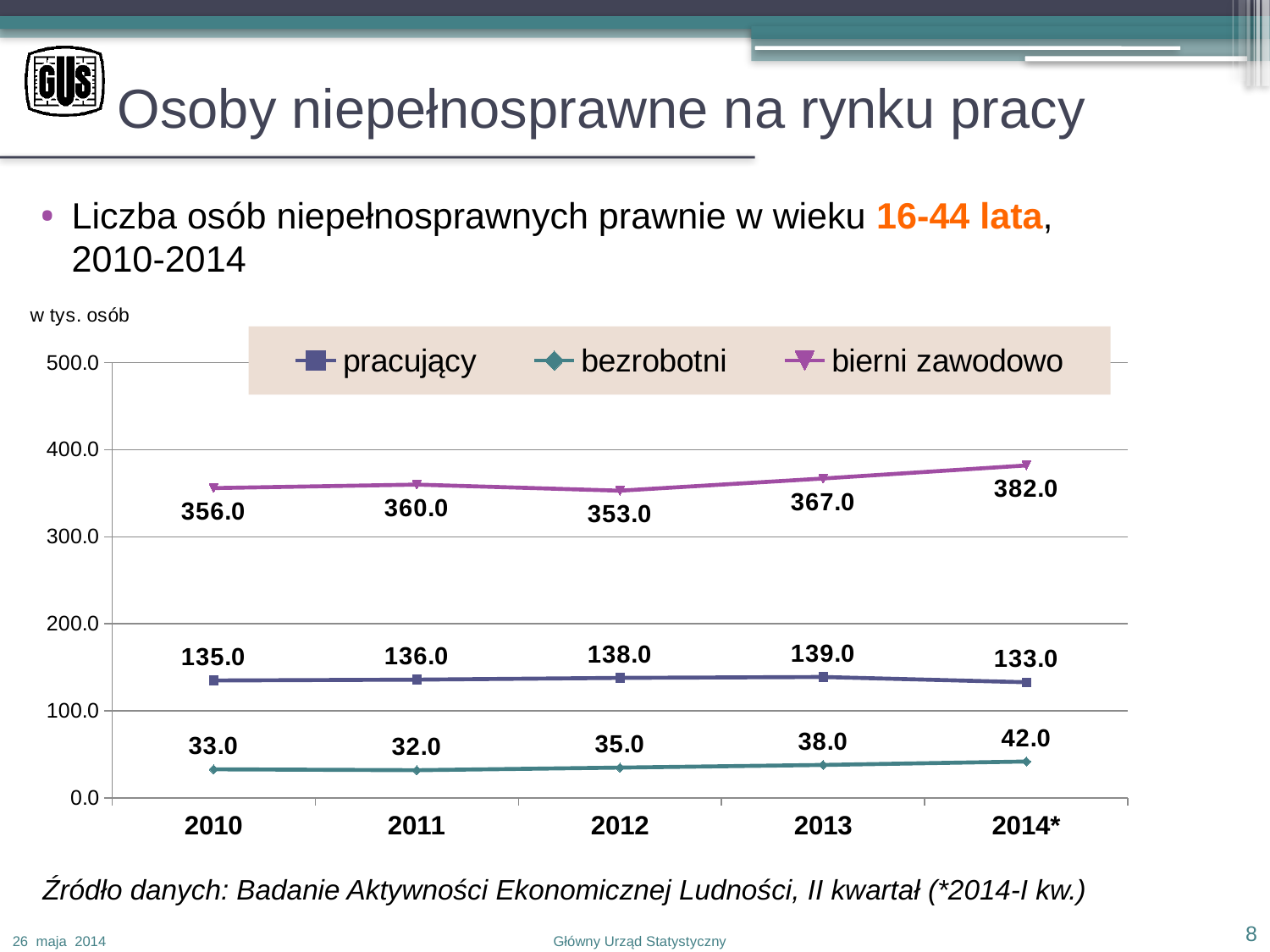
What is the difference between the 'bierni zawodowo' values for 2014* and 2013? 15.0 In which year is the 'bezrobotni' series highest? 2014* What kind of chart is shown on the slide? line chart Does the 'bezrobotni' series rise or fall from 2011 to 2014*? rise What is the value for 'bierni zawodowo' in 2014*? 382.0 Which is larger: 'pracujący' in 2013 or 'pracujący' in 2014*? 2013 How many series does the legend list? 3 What is the value for 'pracujący' in 2012? 138.0 How many years are shown on the x axis? 5 What is the value for 'bezrobotni' in 2011? 32.0 In which year is the 'bierni zawodowo' series lowest? 2012 Is the value for 'bierni zawodowo' in 2010 greater or less than 400.0? less